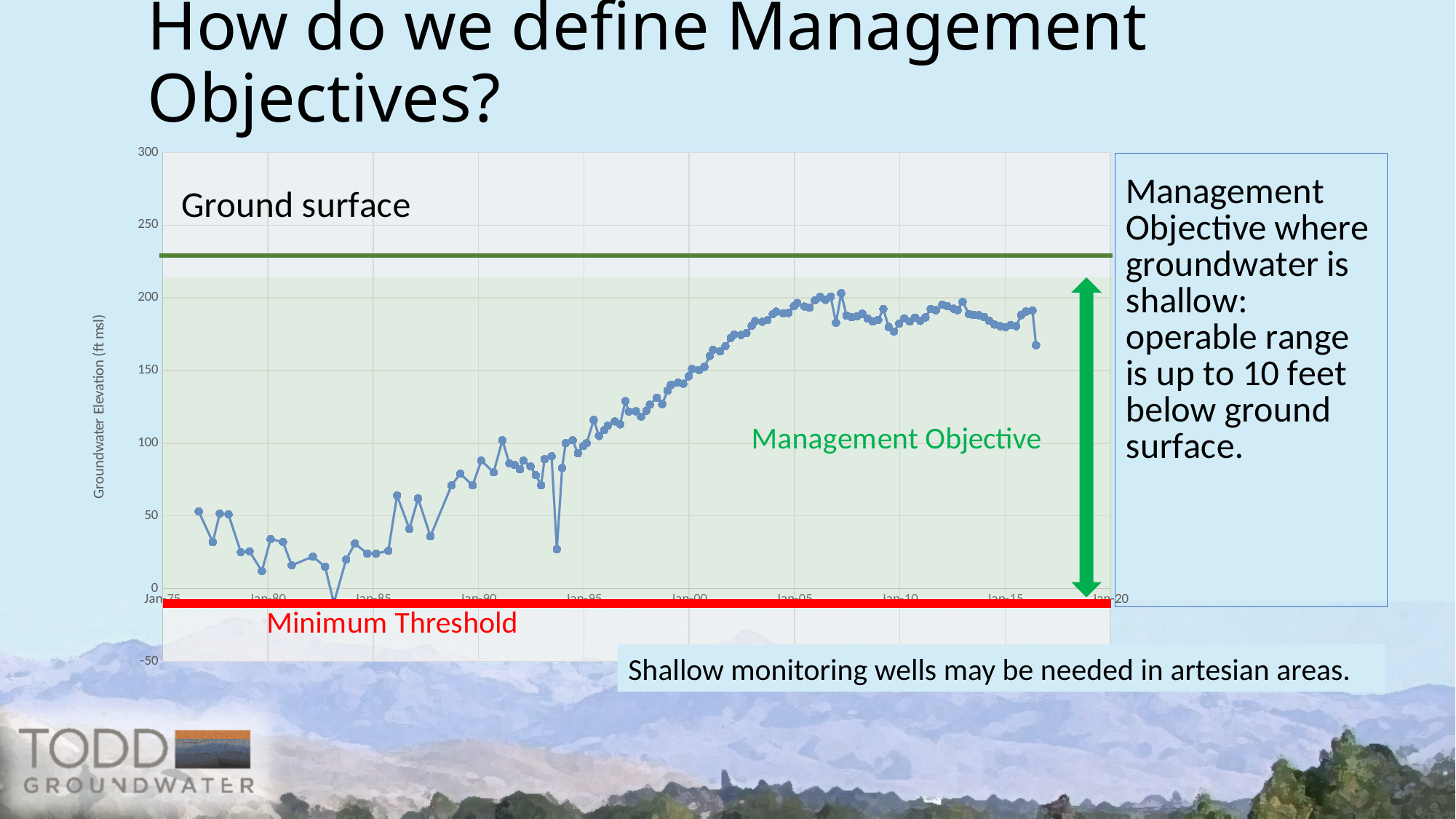
Is the plotted value around Jan-00 greater or less than 100? greater Is the plotted value around Jan-95 greater or less than 50? greater How many labelled tick marks are on the x axis of the chart? 10 Is the plotted value around Jan-80 greater or less than 50? less What is the highest value shown on the y axis of the chart? 300 Which period has higher plotted values: around Jan-80 or around Jan-10? around Jan-10 What kind of chart is shown on the slide? line chart What is the title of the y axis of the chart? Groundwater Elevation (ft msl) Overall, do the plotted groundwater elevation values rise or fall from Jan-75 to Jan-20? rise